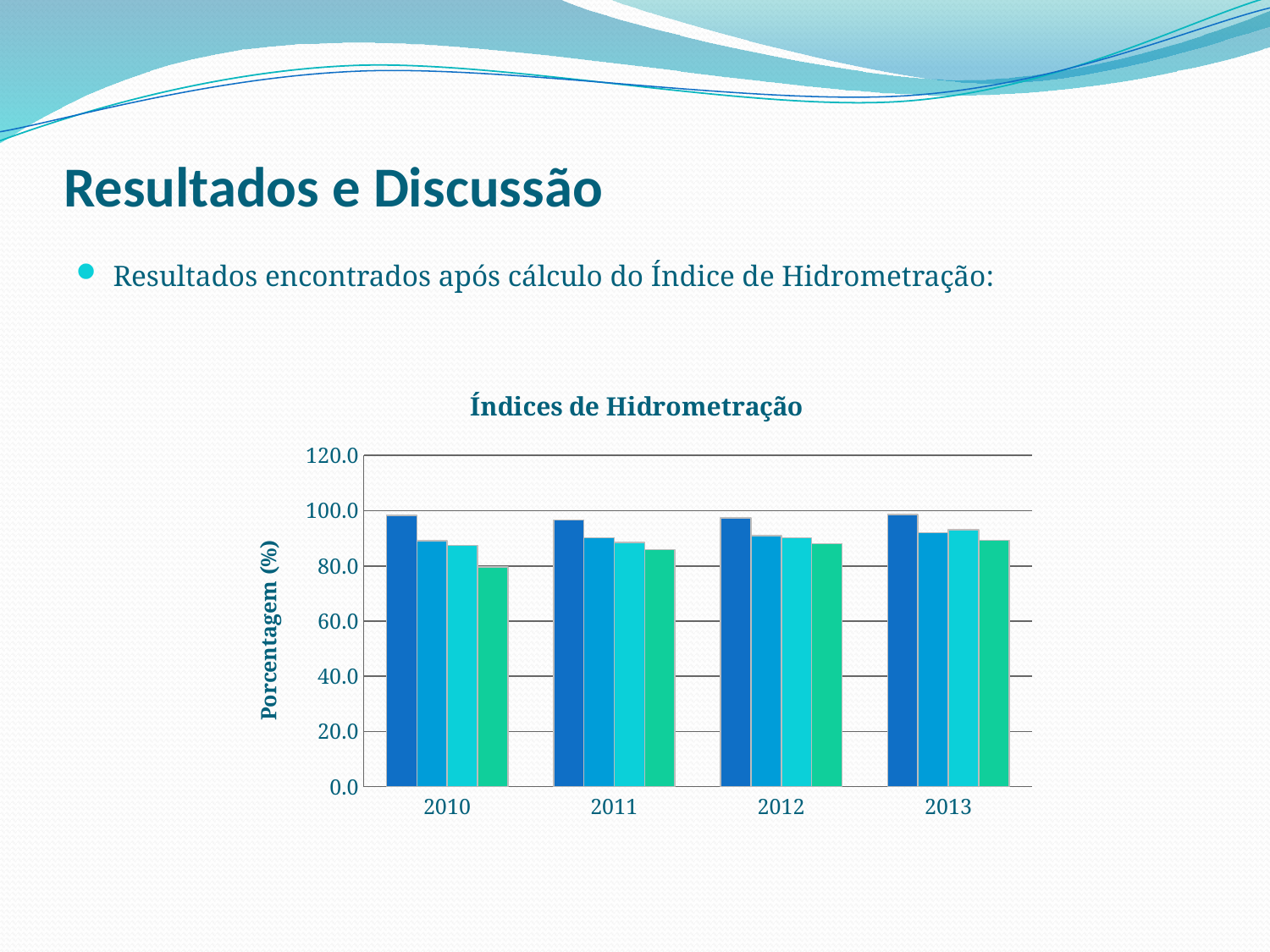
Is the value of the light blue (third) bar for 2012 greater or less than 100.0? less How many years (categories) are shown on the x axis of the chart? 4 Is the value of the green (fourth) bar for 2011 greater or less than 80.0? greater How many bars are plotted for each year in the chart? 4 Within the 2010 group, which bar is the lowest? the green (fourth) bar Is the value of the green (fourth) bar for 2010 greater or less than 60.0? greater What is the label of the vertical axis of the chart? Porcentagem (%) What is the title of the chart? Índices de Hidrometração Within the 2010 group, which bar is the highest? the dark blue (first) bar What kind of chart is shown on the slide? bar chart Do the values of the green (fourth) bars rise or fall from 2010 to 2013? rise